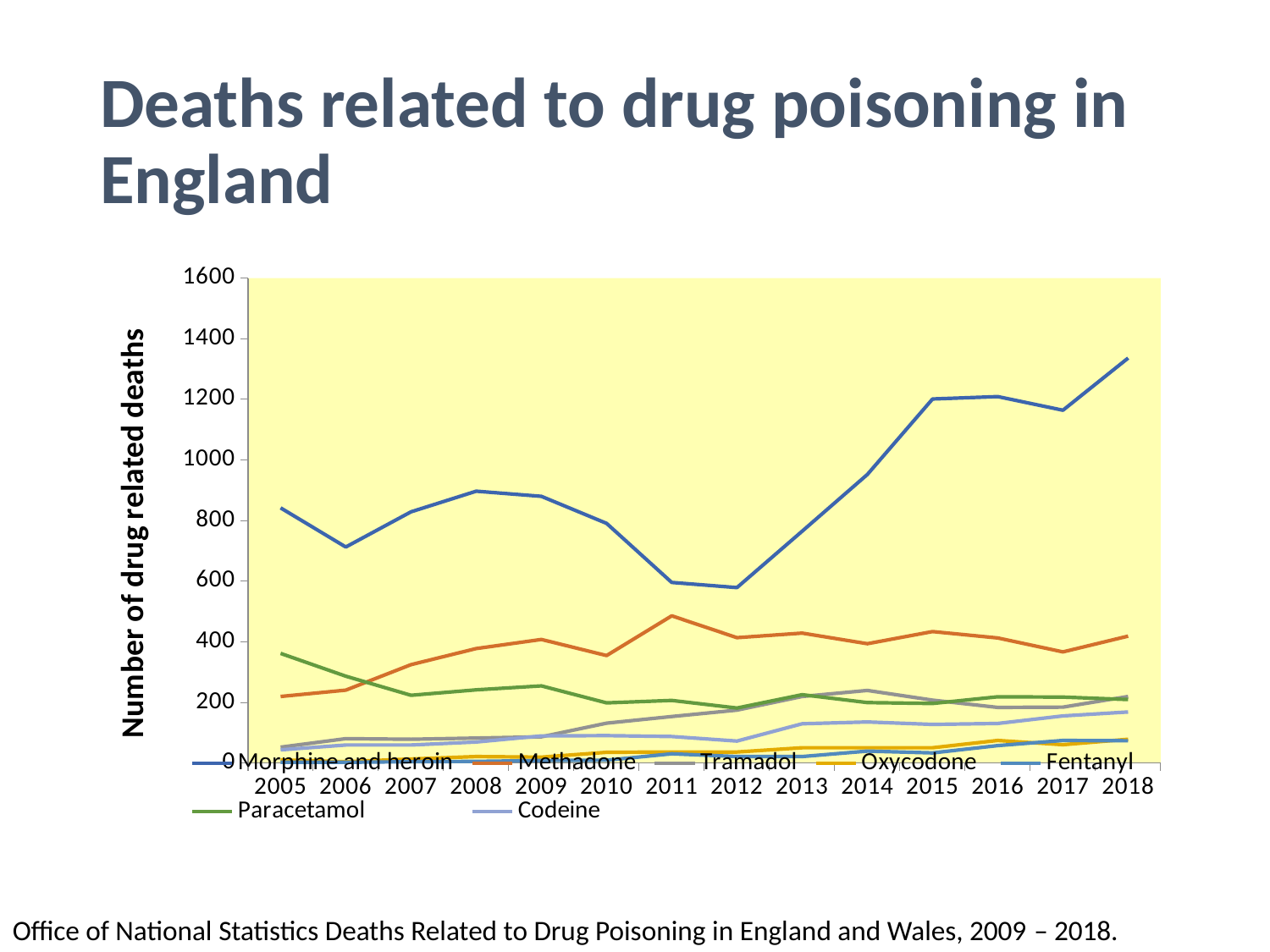
How many years are plotted along the x axis? 14 Is the value for Morphine and heroin in 2006 greater or less than 800? less How many series does the legend list? 7 In which year is the Morphine and heroin series at its highest? 2018 Which series has the highest value in 2018? Morphine and heroin Do the values for Morphine and heroin rise or fall from 2012 to 2015? rise In which year is the Morphine and heroin series at its lowest? 2012 Is the value for Methadone in 2011 greater or less than 400? greater Is the value for Morphine and heroin in 2018 greater or less than 1200? greater What kind of chart is shown on the slide? line chart What is the label on the y axis? Number of drug related deaths Which is larger in 2018, Methadone or Paracetamol? Methadone